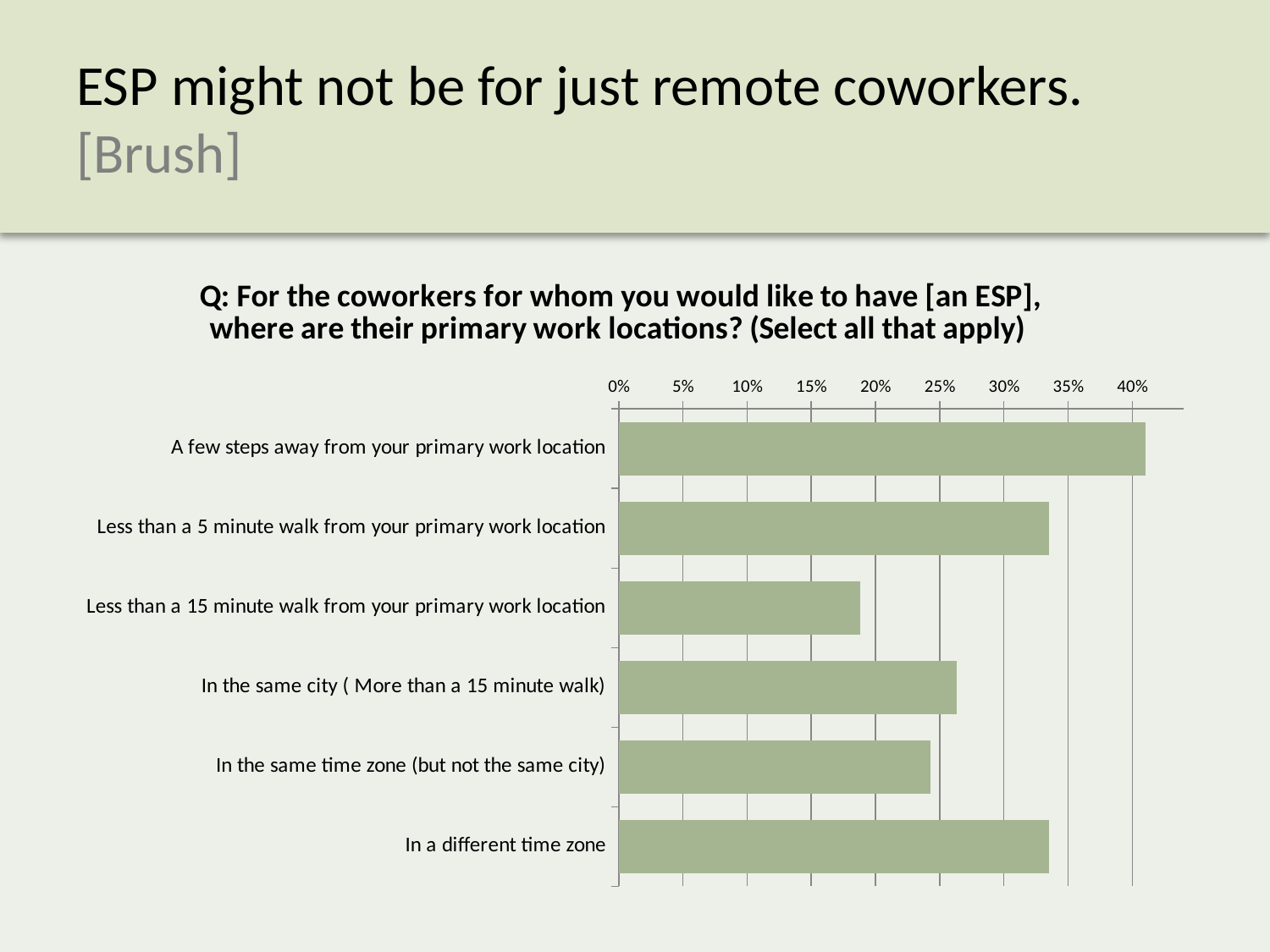
What is the highest percentage label shown on the chart's axis? 40% Which work location has the lowest value in the chart? Less than a 15 minute walk from your primary work location Is the value for 'In a different time zone' greater or less than 30%? greater Which is larger: the value for 'A few steps away from your primary work location' or for 'In the same city ( More than a 15 minute walk)'? A few steps away from your primary work location Is the value for 'In the same city ( More than a 15 minute walk)' greater or less than 30%? less Is the value for 'A few steps away from your primary work location' greater or less than 35%? greater Which work location has the highest value in the chart? A few steps away from your primary work location Which is larger: the value for 'Less than a 15 minute walk from your primary work location' or for 'In the same time zone (but not the same city)'? In the same time zone (but not the same city) How many categories (work locations) are shown in the chart? 6 What kind of chart is shown on the slide? bar chart